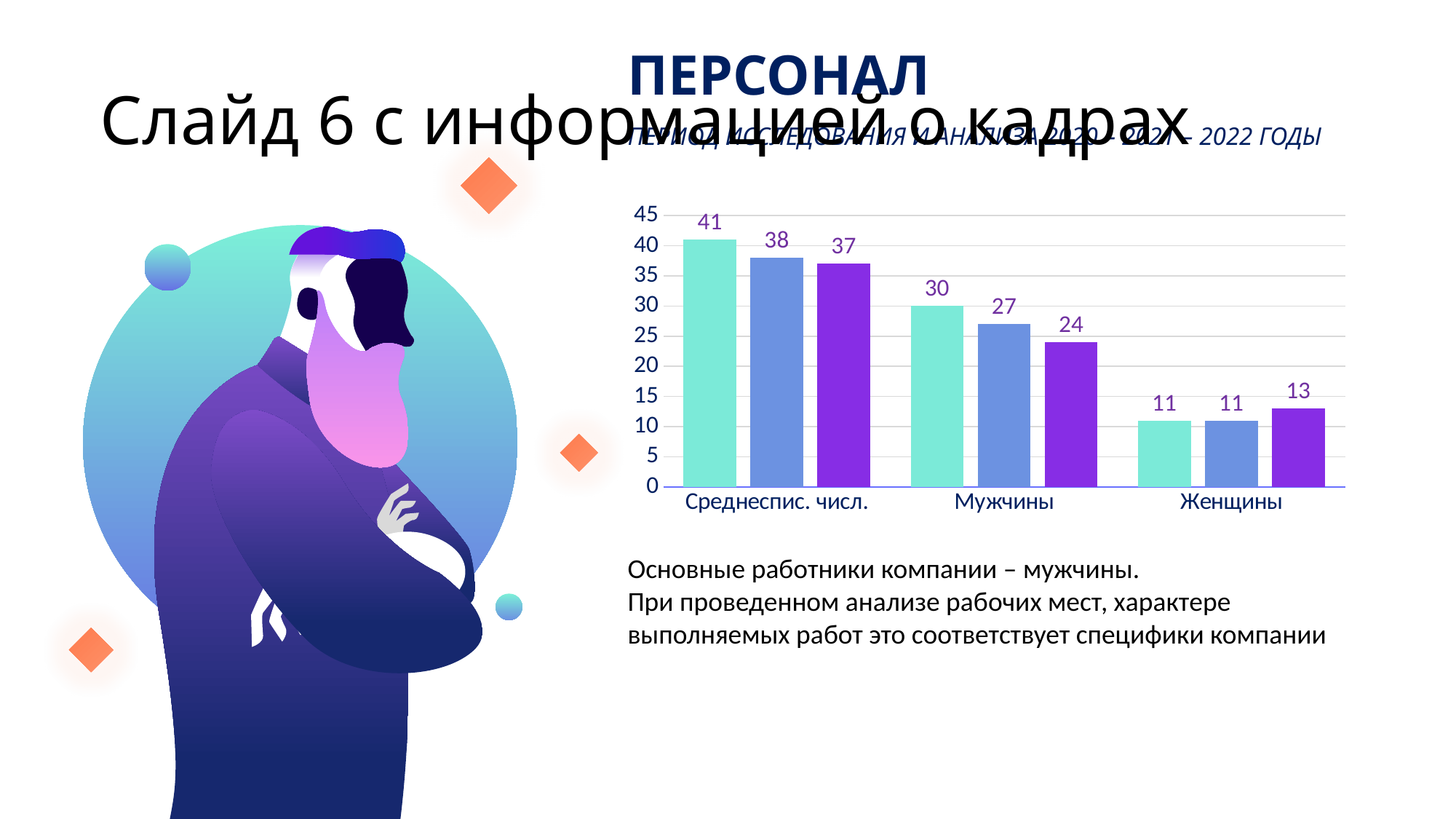
What is the value of the purple (third) bar for Мужчины? 24 How many categories are shown on the x axis of the chart? 3 What is the difference between the teal bar for Мужчины (30) and the purple bar for Мужчины (24)? 6 Which is larger: the blue bar for Среднеспис. числ. or the blue bar for Мужчины? Среднеспис. числ. What is the value of the blue (second) bar for Женщины? 11 What is the value of the purple (third) bar for Женщины? 13 Which category has the lowest bars in the chart? Женщины What type of chart is shown on the slide? bar chart Do the bars for Мужчины rise or fall from the teal bar to the purple bar? fall What is the value of the teal (first) bar for Среднеспис. числ.? 41 What is the title shown above the chart? ПЕРСОНАЛ Which category has the highest bars in the chart? Среднеспис. числ.